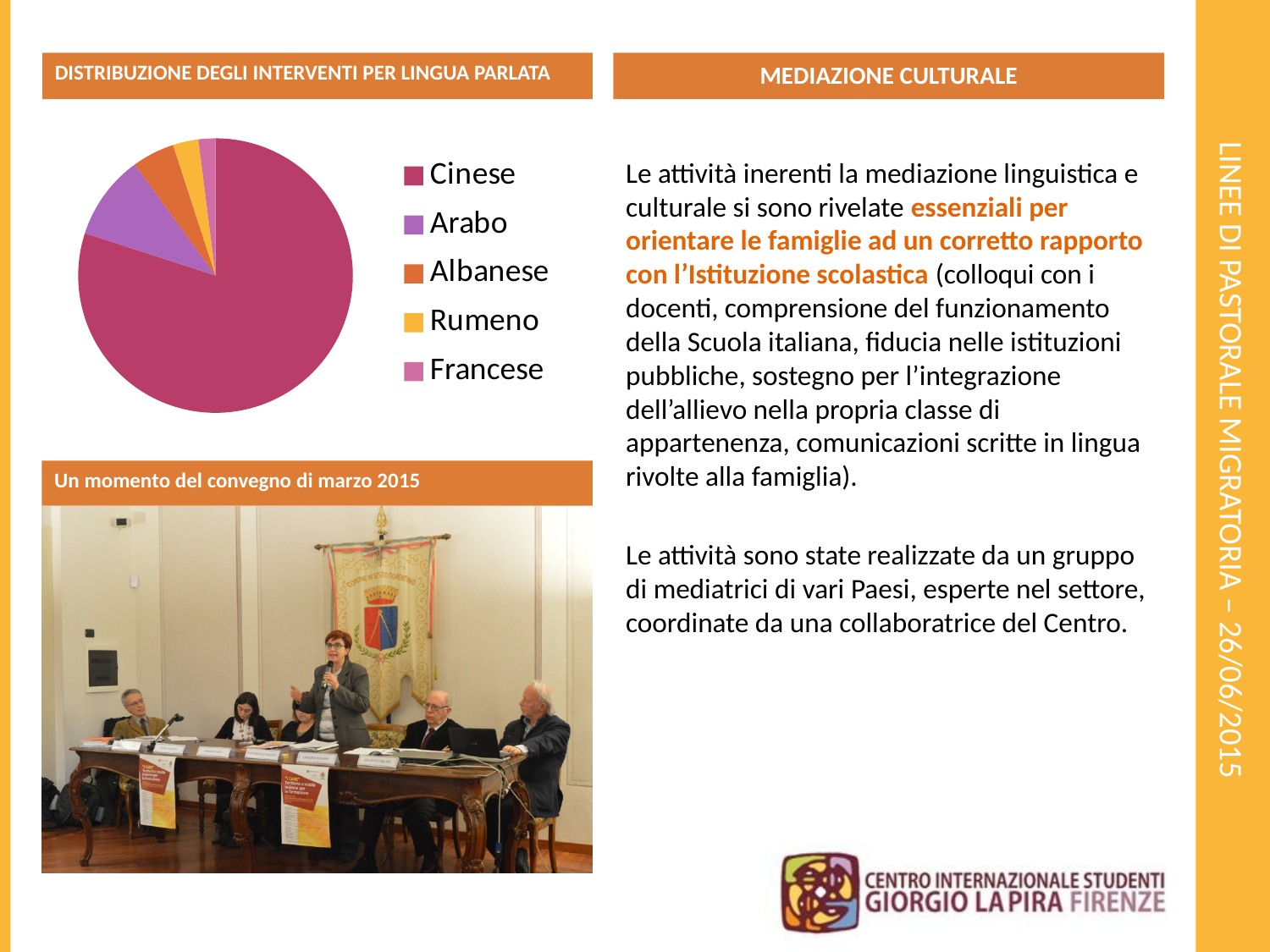
In the pie chart, which slice is larger: Arabo or Francese? Arabo In the pie chart, which slice is larger: Cinese or Arabo? Cinese In the pie chart, which slice is larger: Arabo or Albanese? Arabo What is the title of the pie chart? DISTRIBUZIONE DEGLI INTERVENTI PER LINGUA PARLATA Which language has the smallest slice in the pie chart? Francese What kind of chart is shown under the title "DISTRIBUZIONE DEGLI INTERVENTI PER LINGUA PARLATA"? Pie chart How many language categories does the pie chart show? 5 Which language has the largest slice in the pie chart? Cinese Which language is listed last in the pie chart's legend? Francese